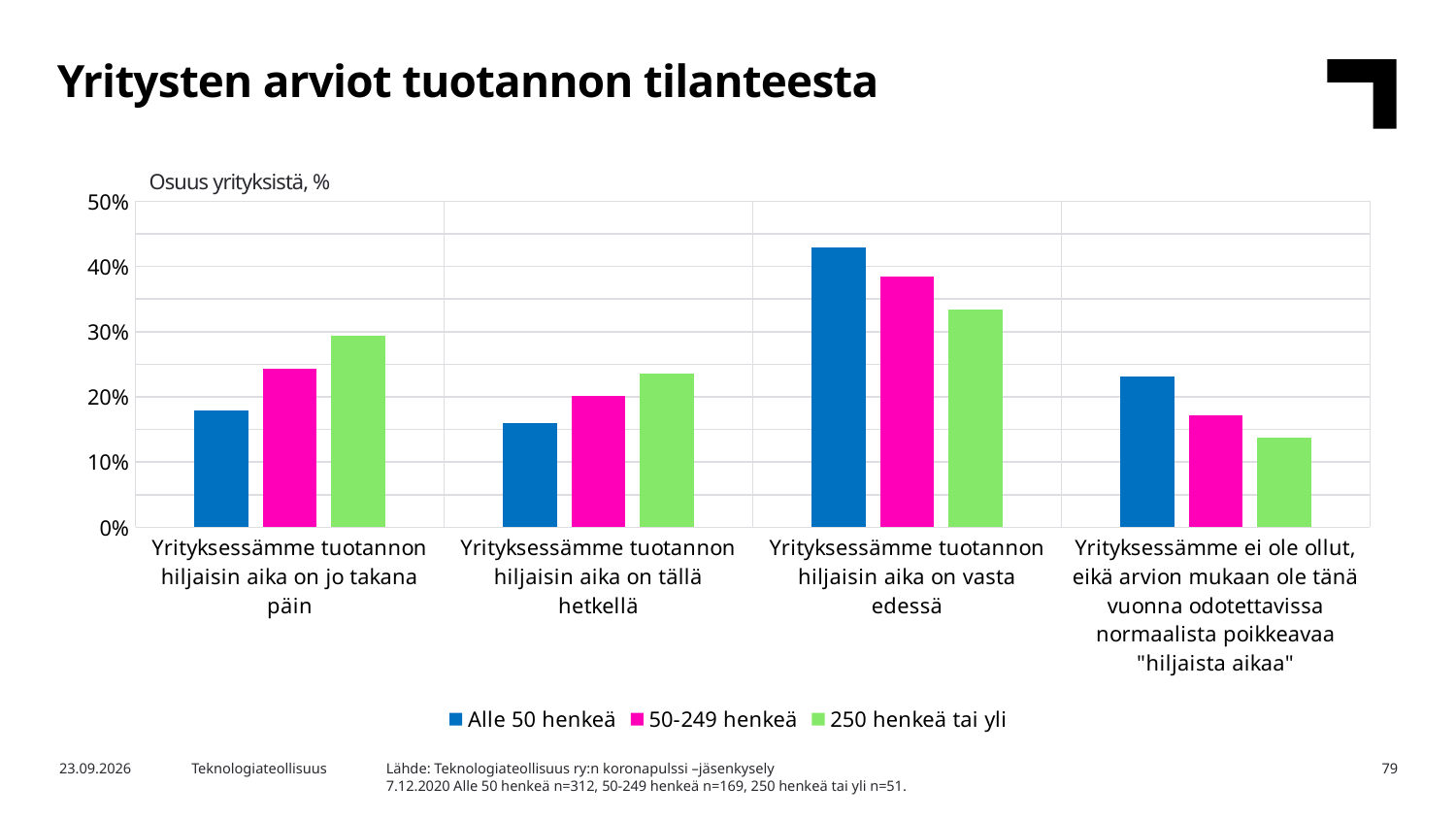
Is the value for 'Alle 50 henkeä' in the category 'Yrityksessämme tuotannon hiljaisin aika on tällä hetkellä' greater or less than 20%? less Which category has the highest value for the 'Alle 50 henkeä' series? Yrityksessämme tuotannon hiljaisin aika on vasta edessä In the category 'Yrityksessämme tuotannon hiljaisin aika on jo takana päin', which series has the larger value: 'Alle 50 henkeä' or '250 henkeä tai yli'? 250 henkeä tai yli How many categories are shown on the x axis? 4 Which category has the lowest value for the '250 henkeä tai yli' series? Yrityksessämme ei ole ollut, eikä arvion mukaan ole tänä vuonna odotettavissa normaalista poikkeavaa "hiljaista aikaa" Is the value for 'Alle 50 henkeä' in the category 'Yrityksessämme tuotannon hiljaisin aika on vasta edessä' greater or less than 40%? greater What type of chart is shown on the slide? bar chart In the category 'Yrityksessämme ei ole ollut, eikä arvion mukaan ole tänä vuonna odotettavissa normaalista poikkeavaa "hiljaista aikaa"', which series has the larger value: 'Alle 50 henkeä' or '50-249 henkeä'? Alle 50 henkeä What is the title of the slide? Yritysten arviot tuotannon tilanteesta What colour represents the '50-249 henkeä' series? pink How many series does the legend list? 3